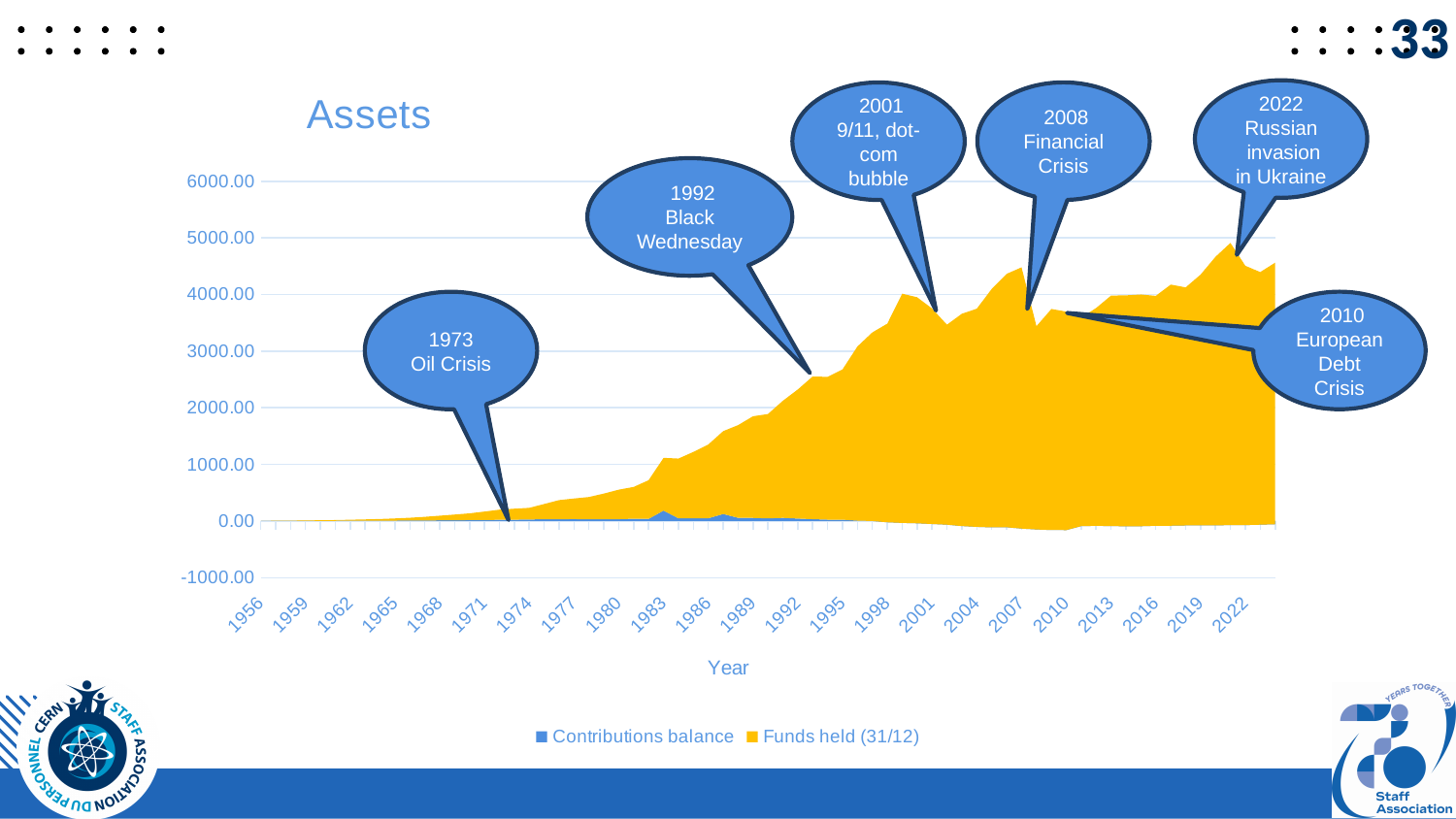
Is the value of Contributions balance in 1983 greater or less than 1000.00? less Is the value of Funds held (31/12) in 2022 greater or less than 4000.00? greater Which is larger, Funds held (31/12) in 2007 or in 2010? 2007 Is the value of Funds held (31/12) in 2007 greater or less than 4000.00? greater Which is larger, Funds held (31/12) in 1980 or in 2022? 2022 How many series does the legend list? 2 What is the title of the x axis? Year Overall, do the Funds held (31/12) values rise or fall from 1956 to 2022? rise What kind of chart is shown on the slide? area chart What is the title of the chart? Assets